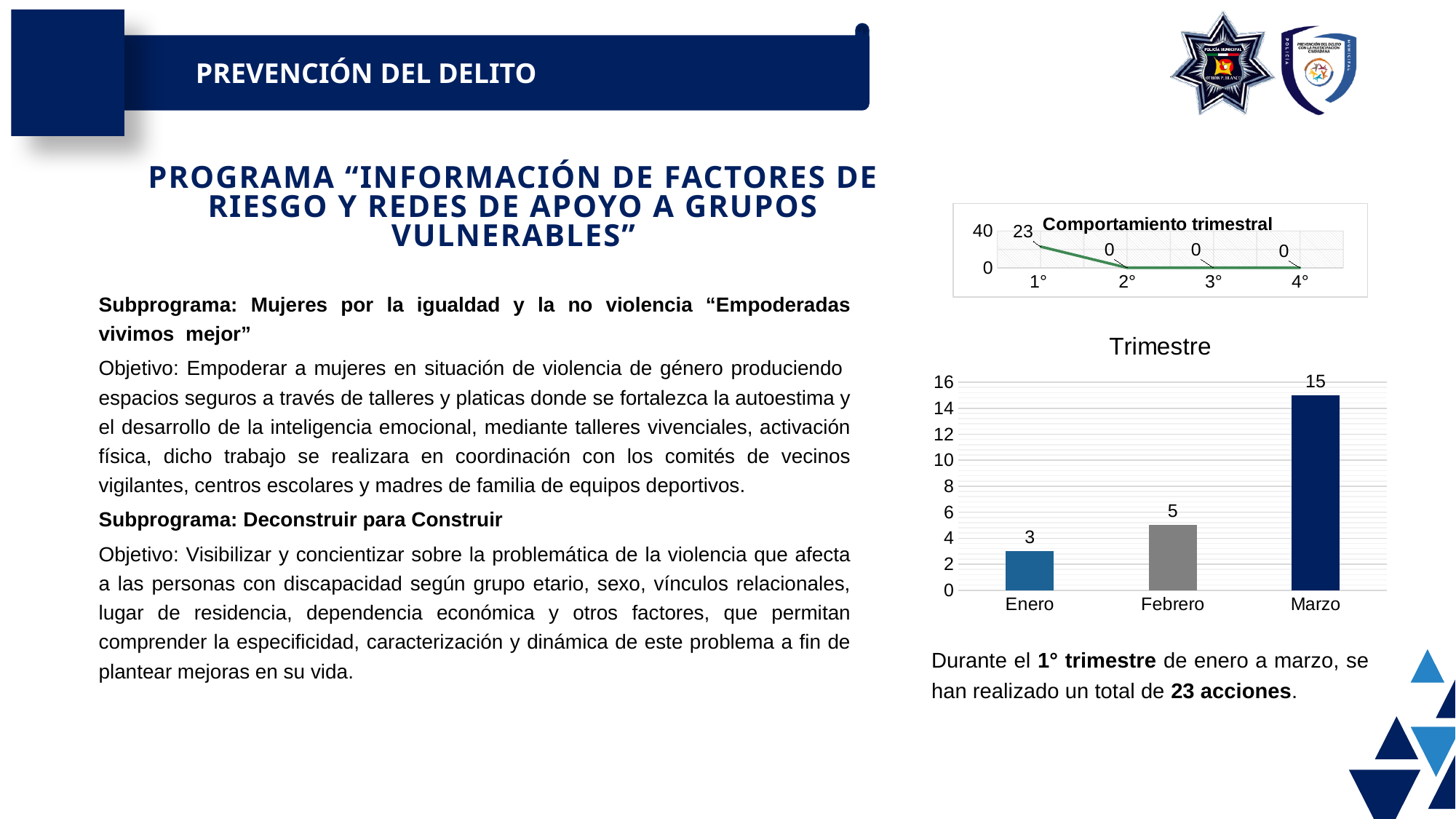
In the 'Trimestre' chart, do the values rise or fall from Enero to Marzo? rise In the 'Trimestre' chart, what is the value for Marzo? 15 What kind of chart is the 'Trimestre' chart? bar chart What kind of chart is the 'Comportamiento trimestral' chart? line chart In the 'Trimestre' chart, what is the value for Febrero? 5 In the 'Trimestre' chart, what is the difference between the values for Marzo and Febrero? 10 In the 'Trimestre' chart, which month has the highest value? Marzo In the 'Trimestre' chart, which is larger, the value for Enero or the value for Febrero? Febrero In the 'Comportamiento trimestral' chart, what is the value for 1°? 23 In the 'Trimestre' chart, what is the value for Enero? 3 In the 'Trimestre' chart, which month has the lowest value? Enero How many months are shown in the 'Trimestre' chart? 3